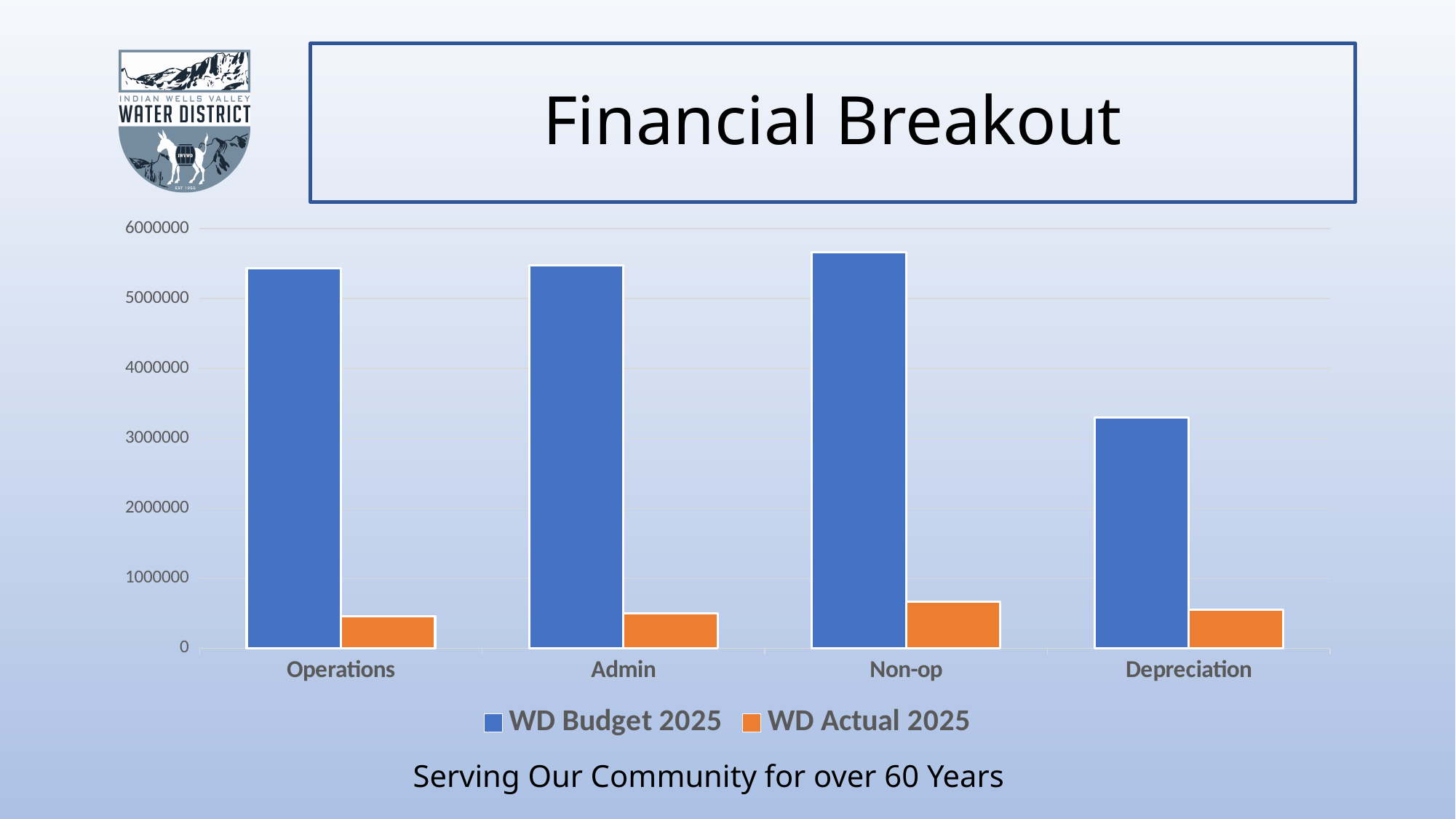
What kind of chart is shown on the slide? bar chart How many categories are shown on the x axis of the chart? 4 Is the WD Budget 2025 value for Depreciation greater or less than 3000000? greater What is the title of the slide containing the chart? Financial Breakout Which is larger: the WD Budget 2025 value for Non-op or for Depreciation? Non-op Which category has the lowest WD Budget 2025 value? Depreciation How many series does the chart's legend list? 2 Which category has the highest WD Budget 2025 value? Non-op Is the WD Budget 2025 value for Operations greater or less than 5000000? greater Is the WD Actual 2025 value for Non-op greater or less than 1000000? less Which category has the highest WD Actual 2025 value? Non-op